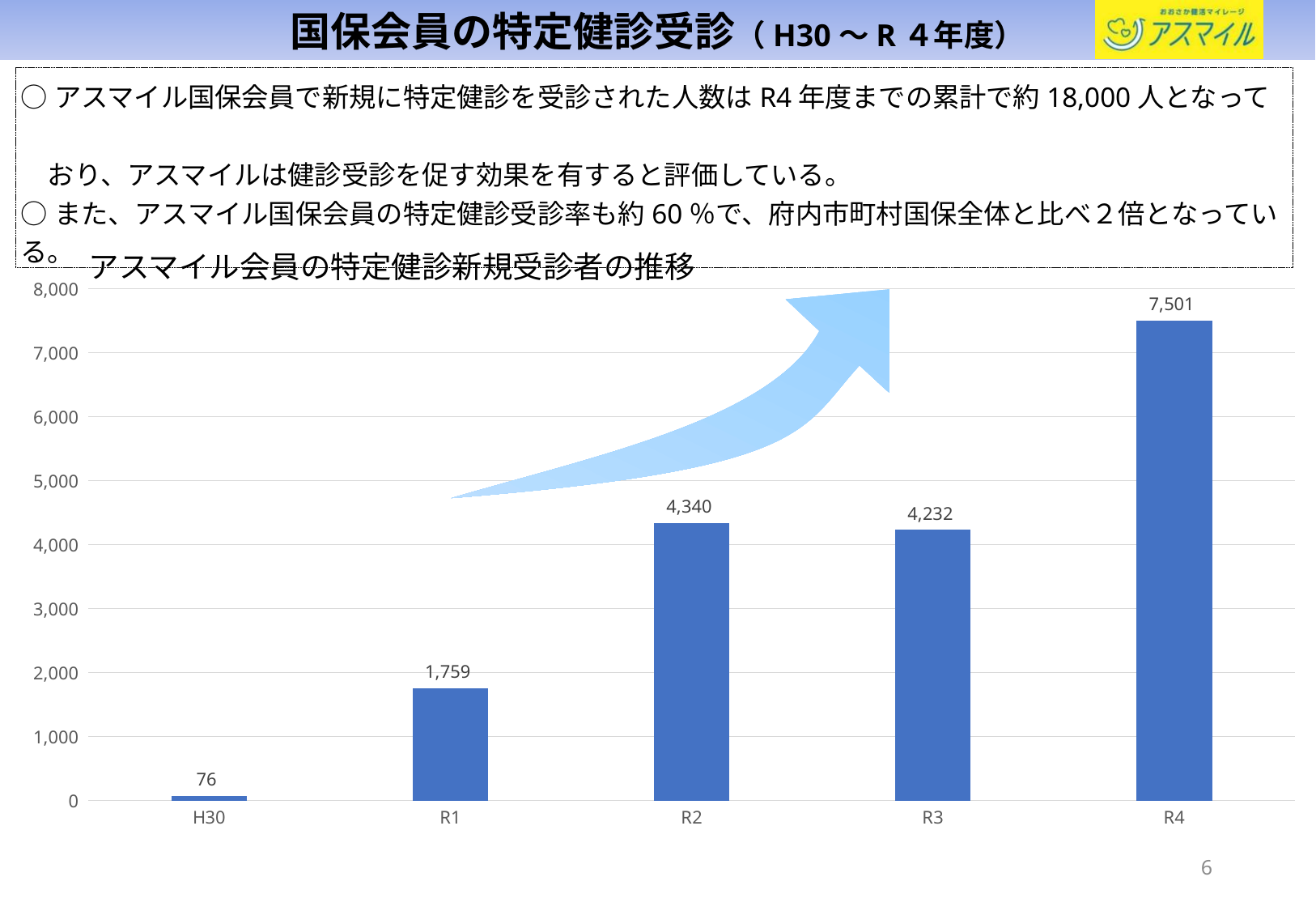
Which category has the highest value? R4 Which is larger, the value for R2 or the value for R3? R2 What is the difference between the values for R4 and R3? 3,269 What is the difference between the values for R2 and R1? 2,581 How many categories are shown on the x axis? 5 What is the value for H30? 76 What is the value for R4? 7,501 Which category has the lowest value? H30 What is the value for R2? 4,340 What kind of chart is shown on the slide? bar chart Is the value for R1 greater or less than 2,000? less What is the title of the chart? アスマイル会員の特定健診新規受診者の推移